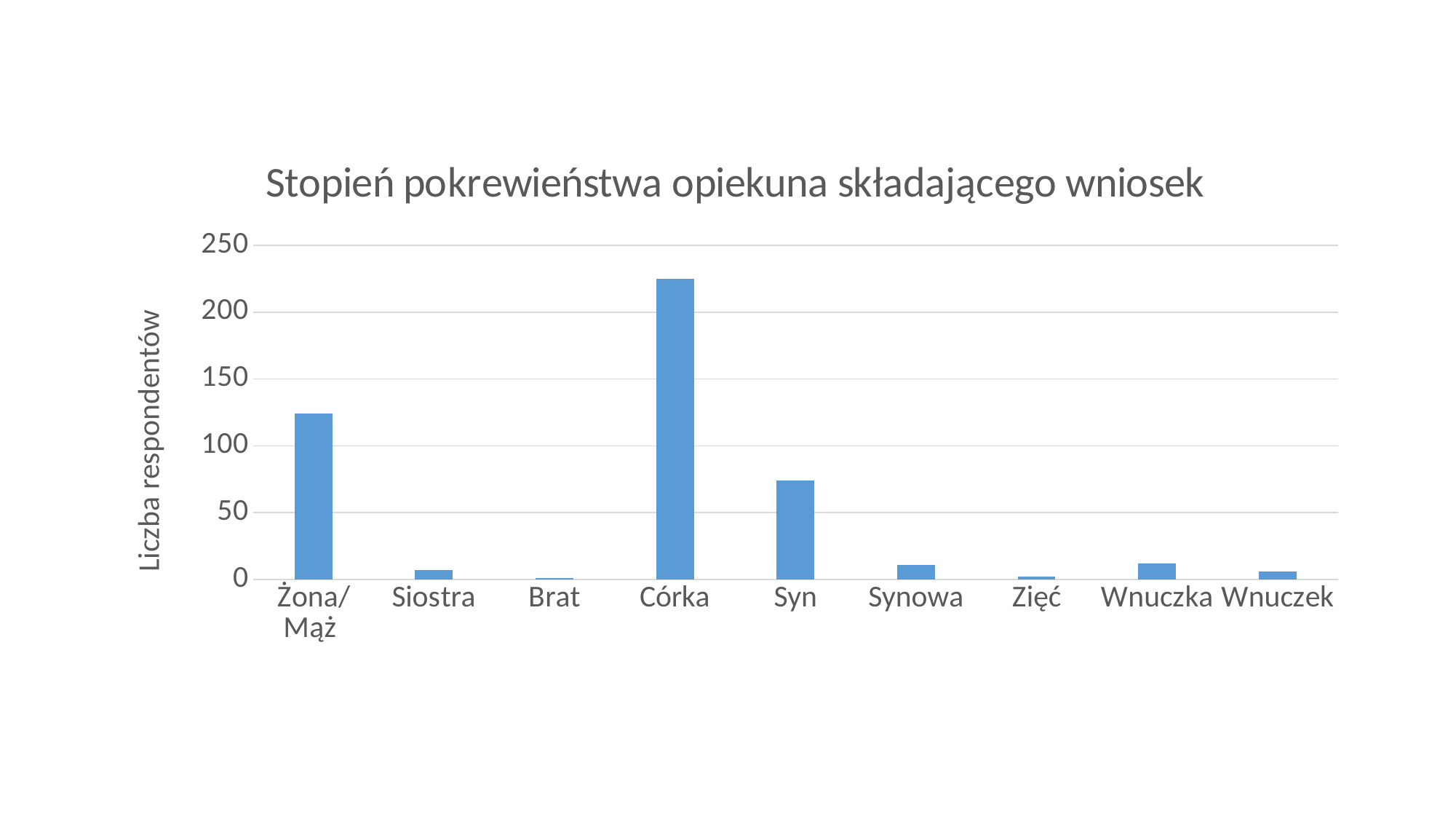
Is the value for Córka greater or less than 200? greater What is the title of the chart? Stopień pokrewieństwa opiekuna składającego wniosek How many categories are shown on the x axis? 9 Which is larger, the value for Wnuczka or the value for Wnuczek? Wnuczka What is the label of the vertical axis? Liczba respondentów Is the value for Żona/Mąż greater or less than 150? less Is the value for Syn greater or less than 50? greater Which category has the highest value? Córka Which is larger, the value for Córka or the value for Żona/Mąż? Córka What kind of chart is shown on the slide? bar chart